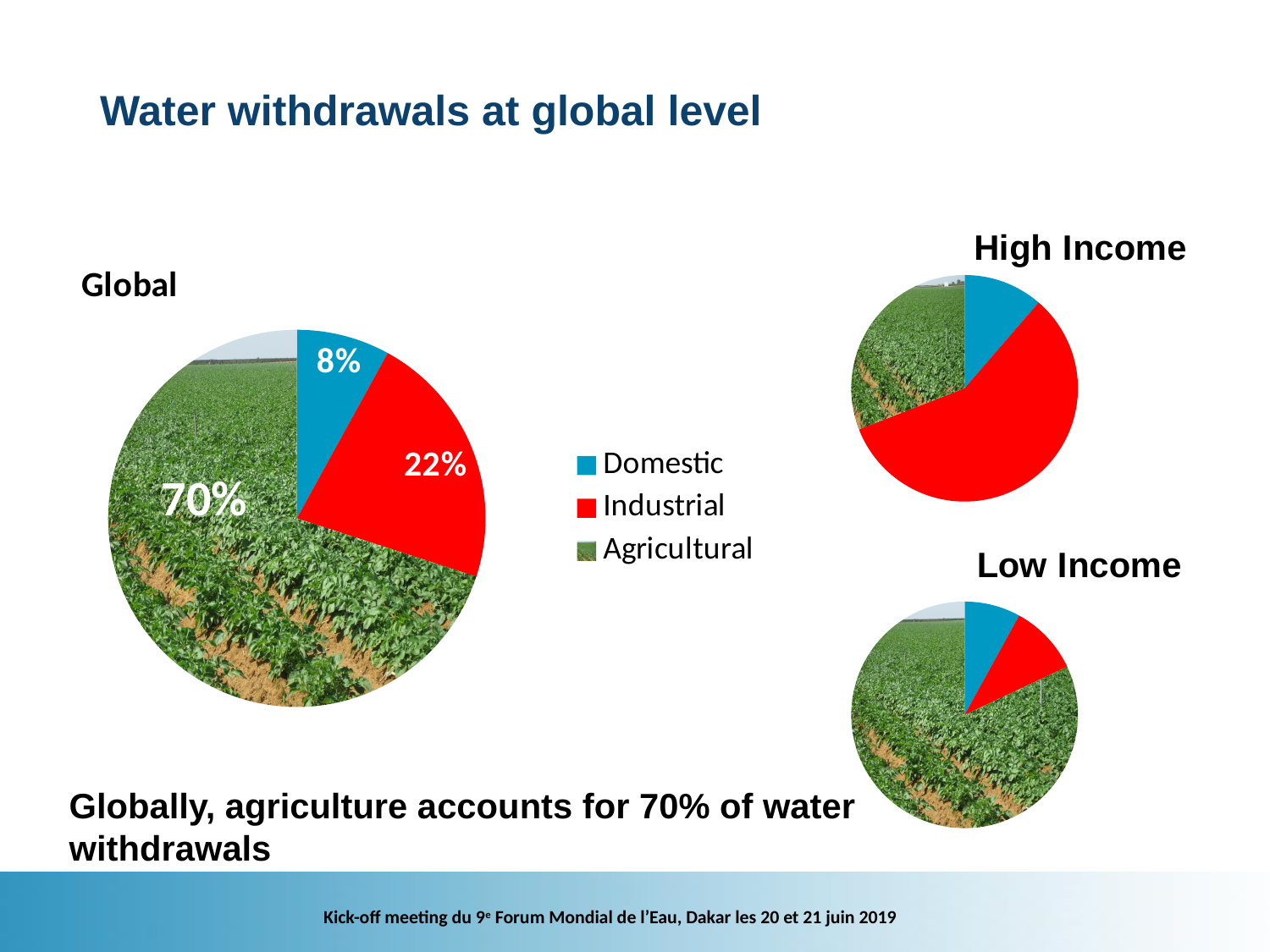
What type of chart is used to show the Global water withdrawals? Pie chart How many categories does the legend list for the pie charts? 3 In the Global pie chart, what percentage of water withdrawals is Agricultural? 70% In the Global pie chart, what percentage of water withdrawals is Industrial? 22% In the Global pie chart, which category has the smallest share? Domestic In the High Income pie chart, which is larger, the Industrial share or the Domestic share? Industrial In the Low Income pie chart, which category has the largest share? Agricultural In the Global pie chart, what percentage of water withdrawals is Domestic? 8% In the Global pie chart, what is the difference in percentage points between the Agricultural and Industrial shares? 48 In the Global pie chart, which category has the largest share? Agricultural In the High Income pie chart, which category has the largest share? Industrial In the Global pie chart, what is the difference in percentage points between the Industrial and Domestic shares? 14